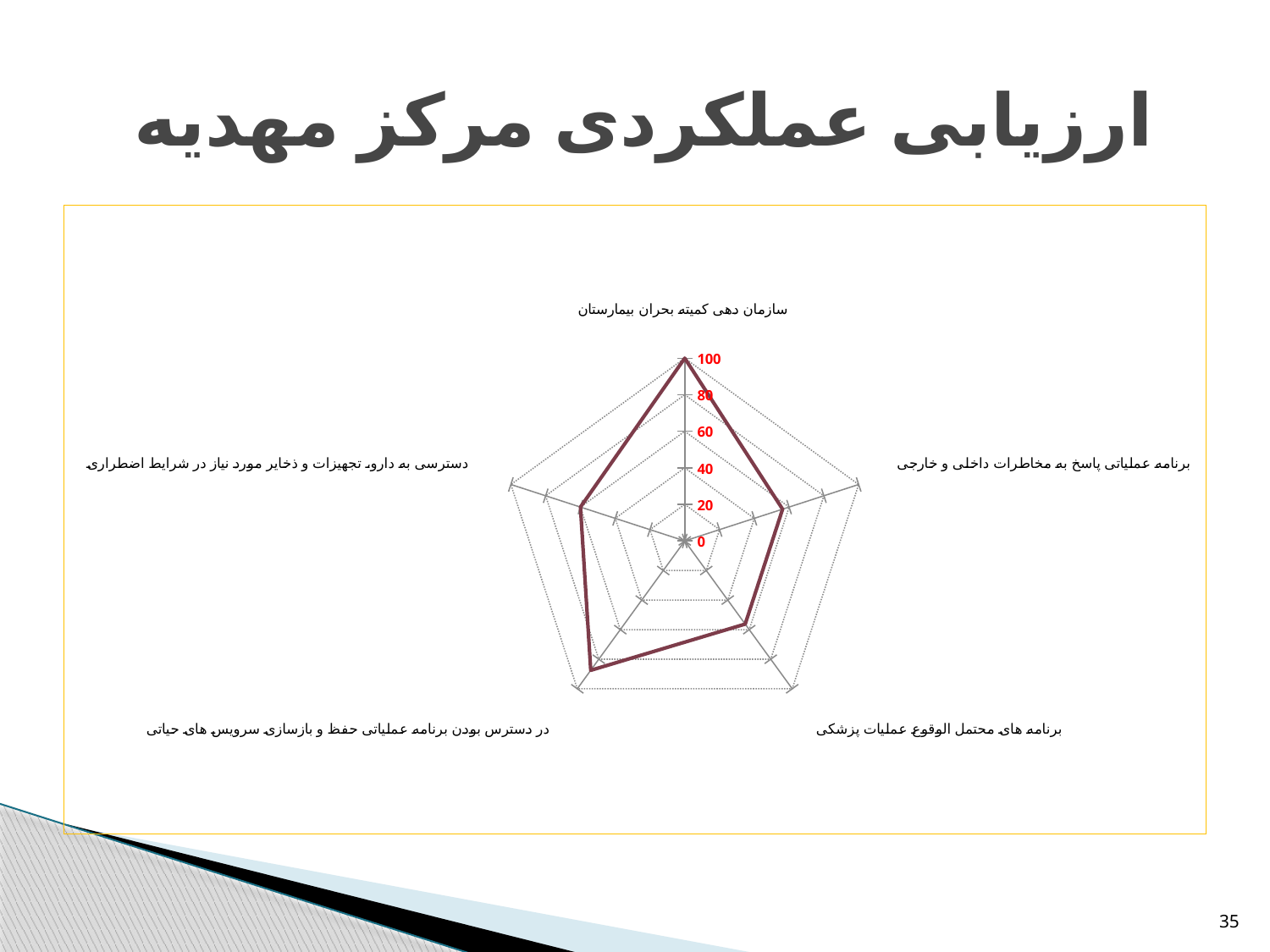
Which category has the highest value on the radar chart? سازمان دهی کمیته بحران بیمارستان Is the value for برنامه های محتمل الوقوع عملیات پزشکی greater or less than 80? less What kind of chart is shown on the slide? radar chart Is the value for در دسترس بودن برنامه عملیاتی حفظ و بازسازی سرویس های حیاتی greater or less than 60? greater Which is larger: the value for سازمان دهی کمیته بحران بیمارستان or the value for برنامه عملیاتی پاسخ به مخاطرات داخلی و خارجی? سازمان دهی کمیته بحران بیمارستان What is the maximum value shown on the radar chart's axis scale? 100 Is the value for دسترسی به دارو، تجهیزات و ذخایر مورد نیاز در شرایط اضطراری greater or less than 40? greater How many categories (axes) does the radar chart have? 5 Which is larger: the value for در دسترس بودن برنامه عملیاتی حفظ و بازسازی سرویس های حیاتی or the value for برنامه های محتمل الوقوع عملیات پزشکی? در دسترس بودن برنامه عملیاتی حفظ و بازسازی سرویس های حیاتی What is the value for سازمان دهی کمیته بحران بیمارستان? 100 What is the title of the slide containing the radar chart? ارزیابی عملکردی مرکز مهدیه